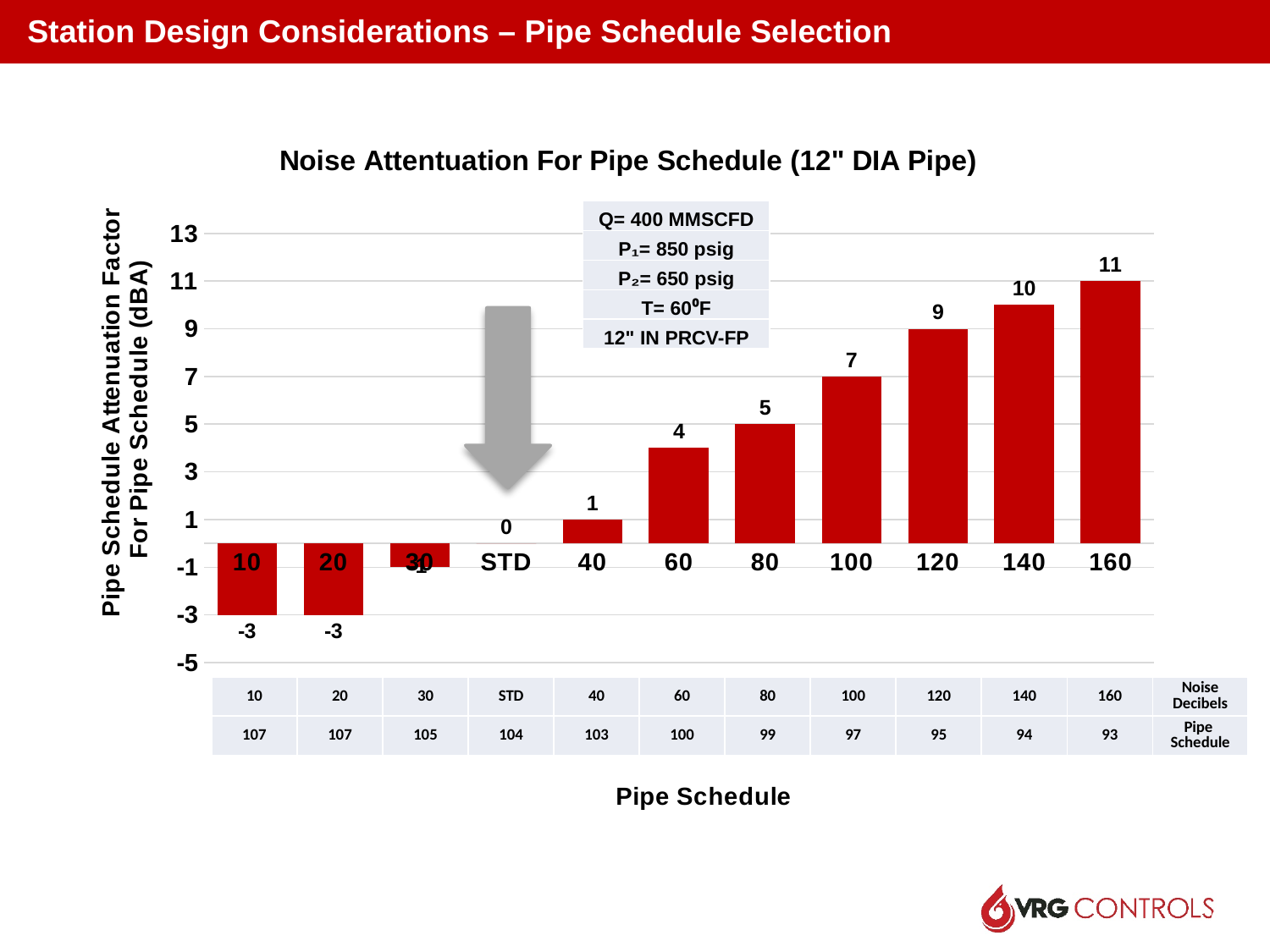
How many pipe schedule categories are plotted on the x axis? 11 What is the attenuation factor for the STD pipe schedule? 0 What type of chart is shown on the slide? bar chart Which pipe schedule has the highest attenuation factor? 160 Do the attenuation factor values rise or fall moving from pipe schedule 10 to 160 along the x axis? rise What colour are the bars in the chart? red What is the difference between the attenuation factors for pipe schedules 140 and 60? 6 What is the attenuation factor for pipe schedule 80? 5 Which has a larger attenuation factor, pipe schedule 100 or pipe schedule 40? 100 What is the attenuation factor for pipe schedule 10? -3 What is the title of the chart? Noise Attentuation For Pipe Schedule (12" DIA Pipe) What is the attenuation factor for pipe schedule 160? 11